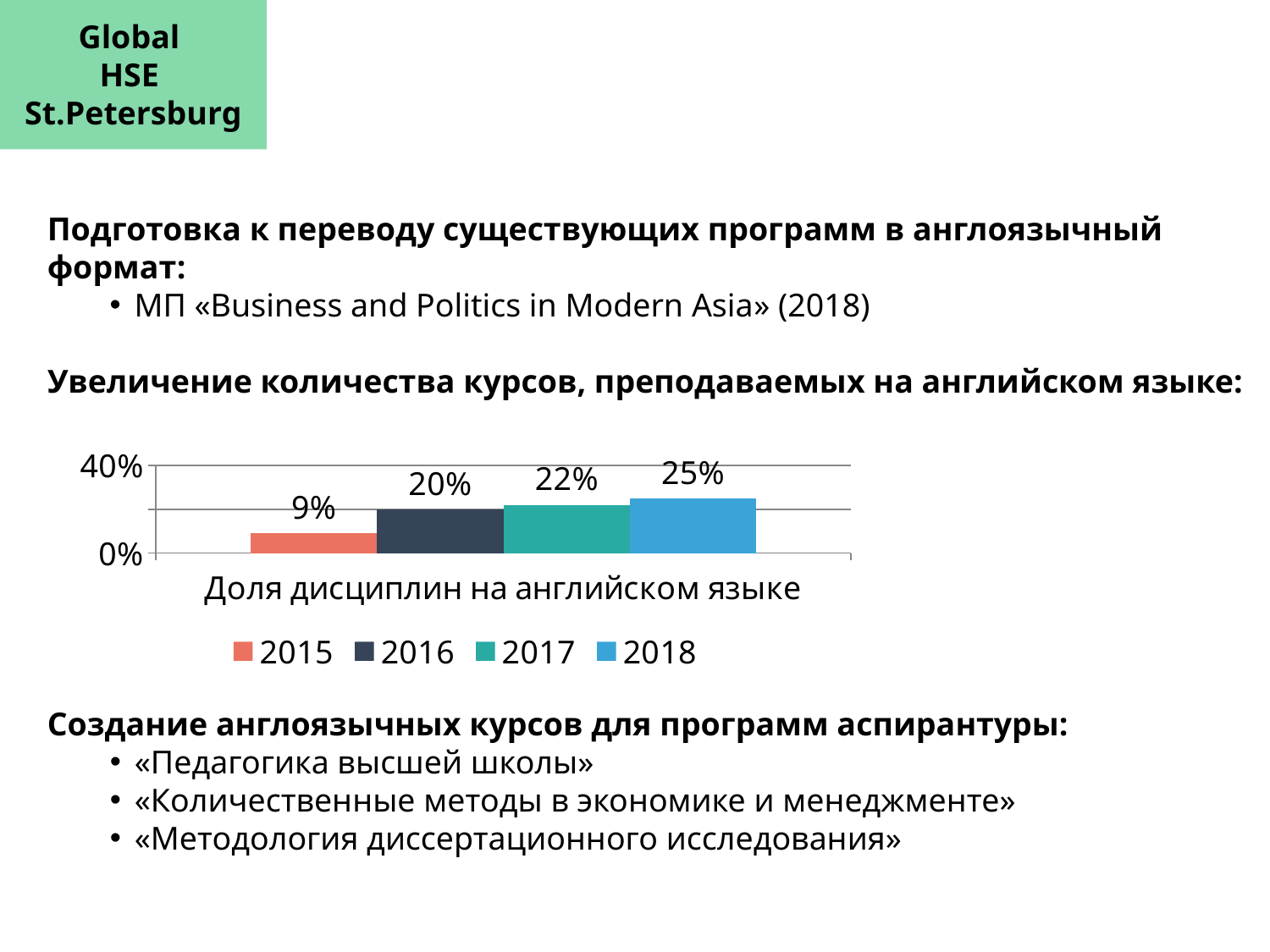
What kind of chart is shown on the slide? Bar chart How many series does the legend list? 4 What is the category label shown under the bars? Доля дисциплин на английском языке Do the values rise or fall from 2015 to 2018? Rise What is the value for 2017 in the chart? 22% What is the difference between the values for 2018 and 2015? 16% What is the value for 2016 in the chart? 20% Which year has the lowest share of disciplines taught in English? 2015 What is the value for 2015 in the chart? 9% What is the value for 2018 in the chart? 25% Which is larger, the value for 2016 or the value for 2018? 2018 Which year has the highest share of disciplines taught in English? 2018